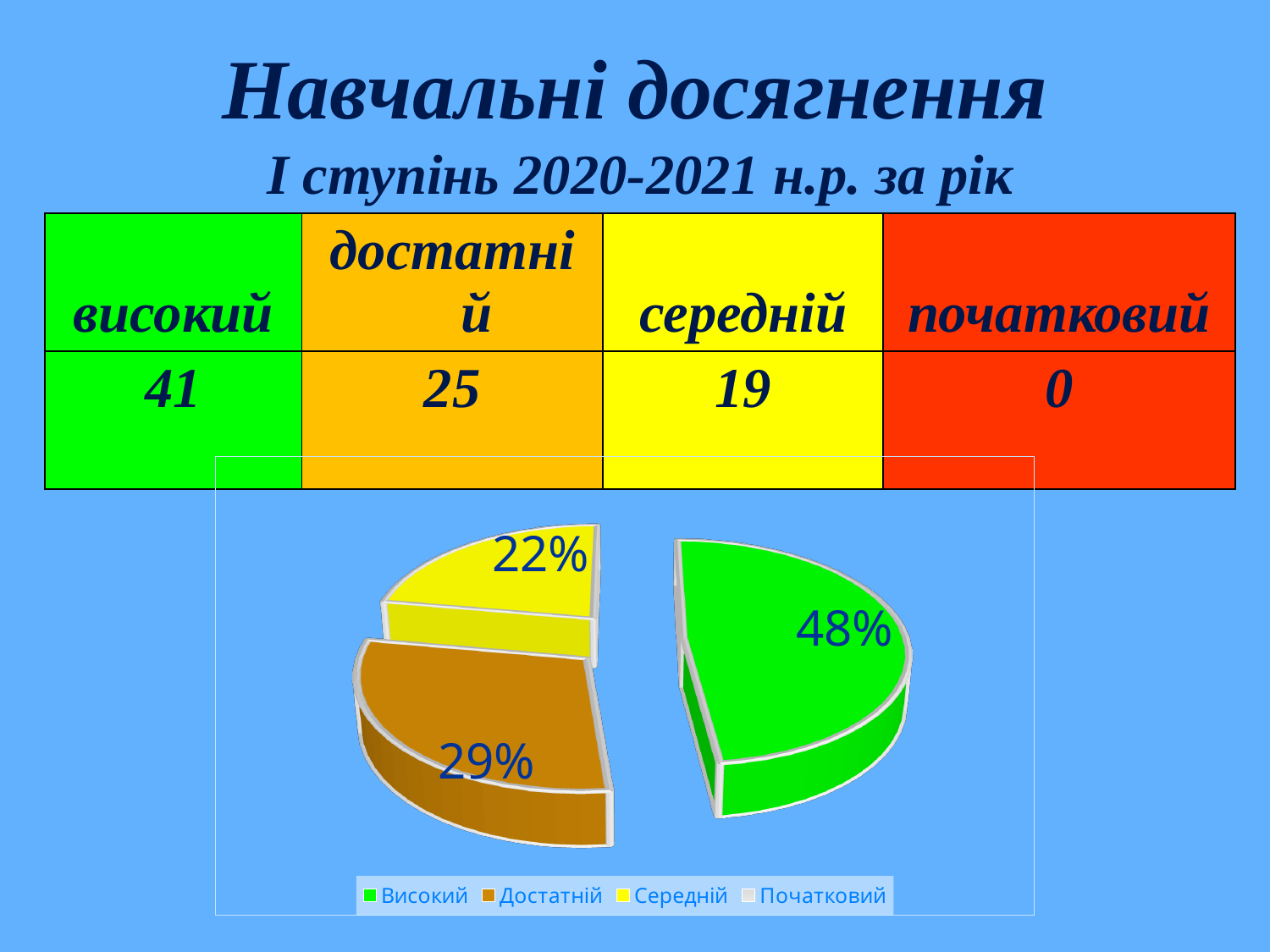
Which legend entry of the pie chart has no visible slice? Початковий Which category has the largest slice in the pie chart? Високий What percentage does the pie chart show for Середній? 22% By how many percentage points does the Високий slice exceed the Достатній slice? 19 By how many percentage points does the Достатній slice exceed the Середній slice? 7 What kind of chart is shown on the slide? pie chart How many entries does the pie chart's legend list? 4 What percentage does the pie chart show for Високий? 48% What percentage does the pie chart show for Достатній? 29% Which of the labelled slices in the pie chart is the smallest? Середній Which is larger in the pie chart, the share for Достатній or the share for Середній? Достатній What colour is the Високий slice in the pie chart? green